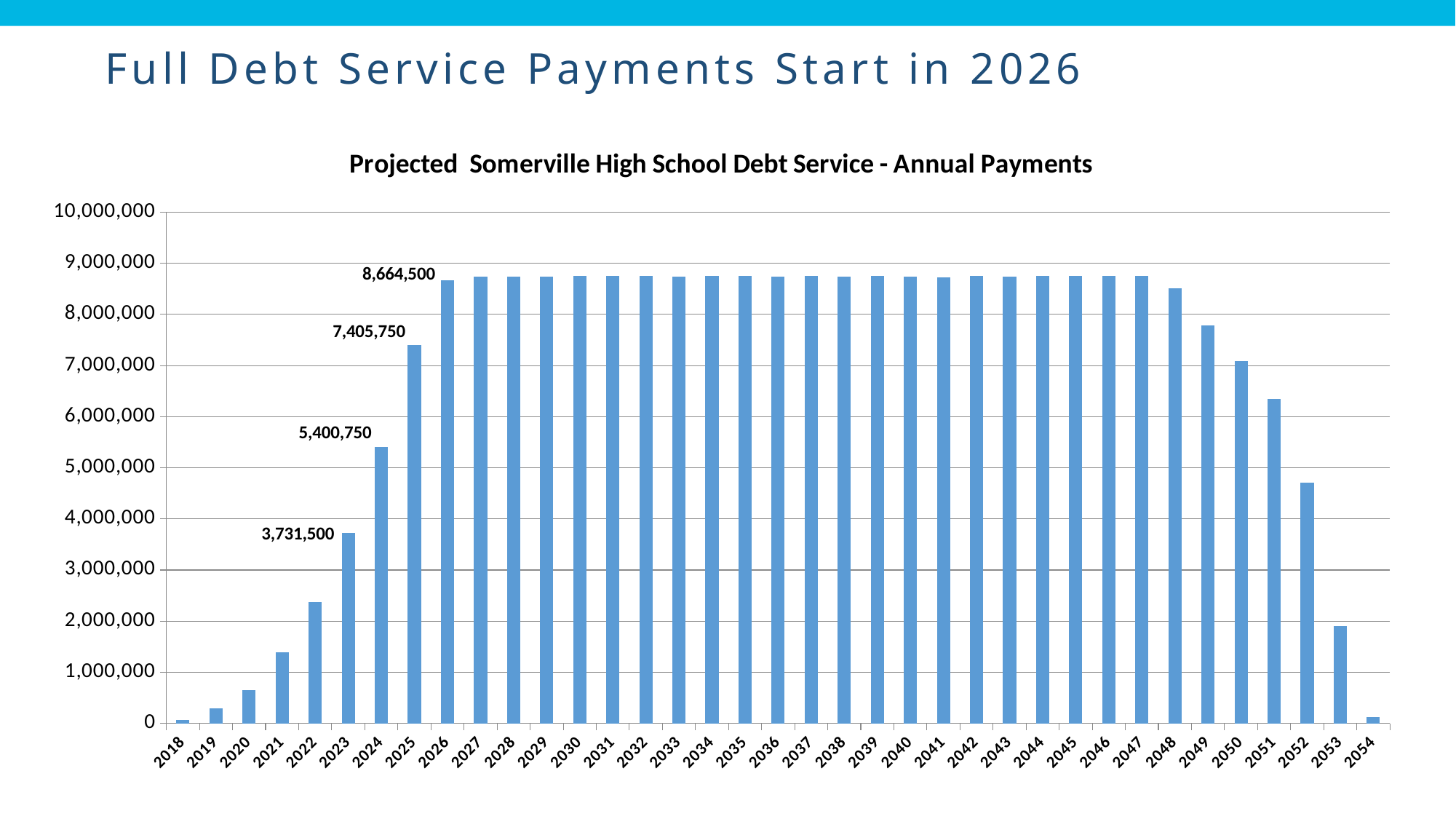
Is the value for 2052 greater or less than 5,000,000? less What kind of chart is shown on the slide? bar chart What is the value for 2023? 3,731,500 Which is larger, the value for 2023 or the value for 2024? 2024 What is the value for 2026? 8,664,500 What is the value for 2024? 5,400,750 Is the value for 2054 greater or less than 1,000,000? less How many years are shown on the x axis? 37 Is the value for 2049 greater or less than 7,000,000? greater What is the difference between the values for 2026 and 2025? 1,258,750 What is the difference between the values for 2024 and 2023? 1,669,250 What is the value for 2025? 7,405,750